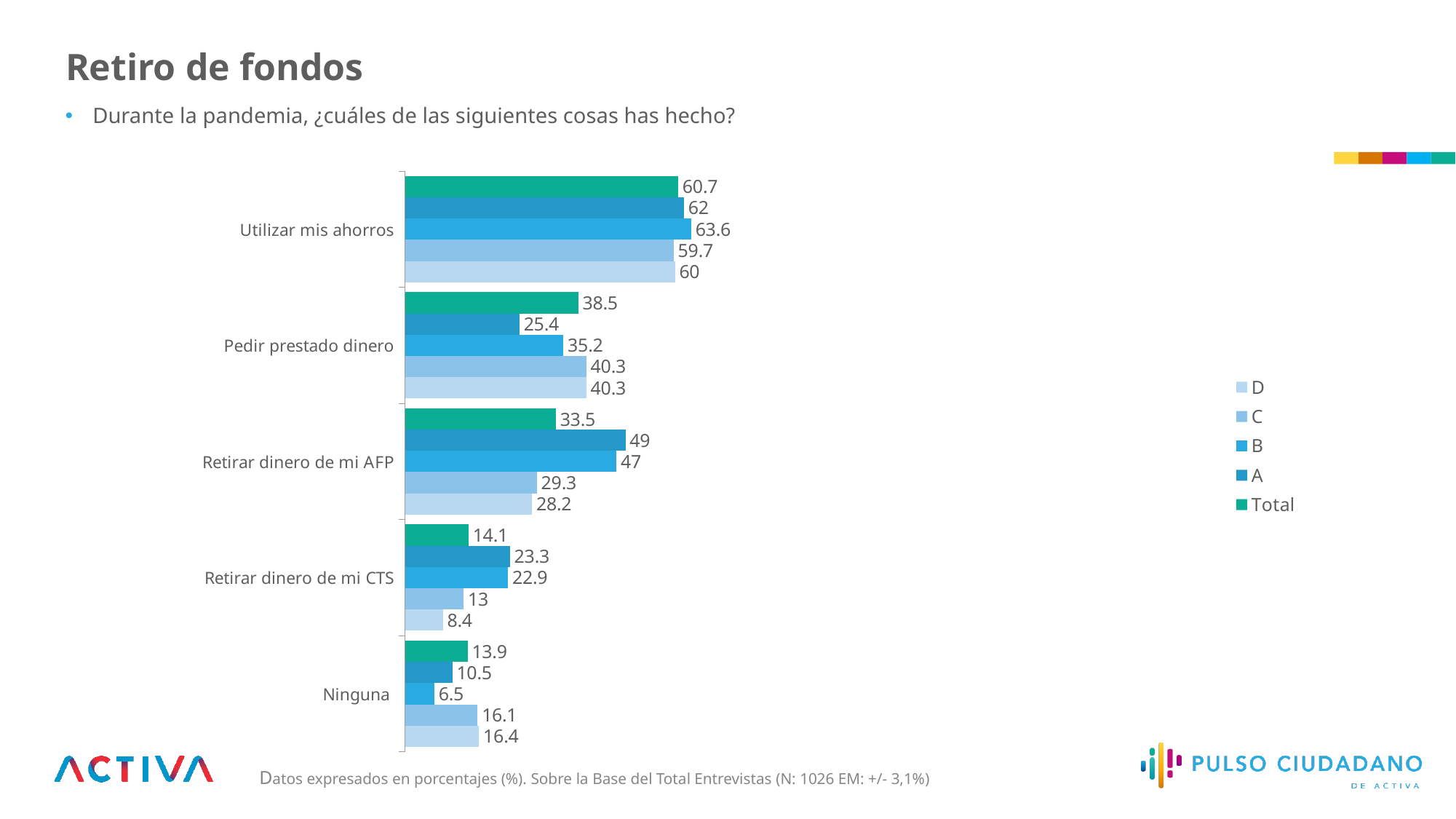
How many series does the legend list? 5 Which is larger for "Retirar dinero de mi AFP": the value for series A or series C? A What is the value for series B in the "Retirar dinero de mi AFP" category? 47 What is the value for series A in the "Pedir prestado dinero" category? 25.4 Which category has the highest Total value? Utilizar mis ahorros What is the Total value for "Utilizar mis ahorros"? 60.7 What is the difference between the series A and series D values for "Retirar dinero de mi CTS"? 14.9 What is the value for series D in the "Ninguna" category? 16.4 How many categories are shown on the chart? 5 What kind of chart is shown on the slide? Bar chart Which category has the lowest value for series B? Ninguna Which series is shown in green in the legend? Total